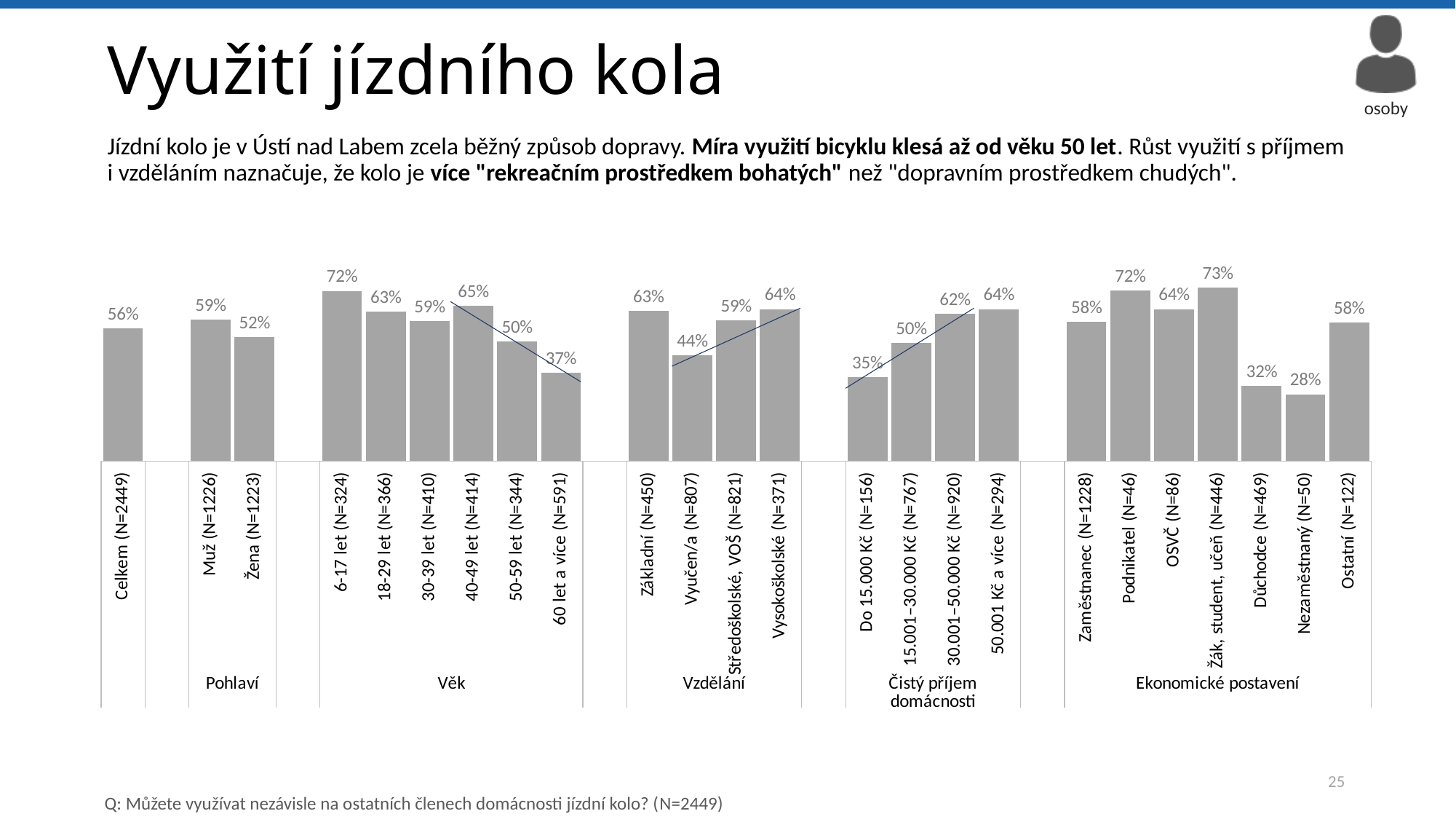
What is the value for Vyučen/a? 44% Which category in the Ekonomické postavení group has the highest value? Žák, student, učeň Which is larger, the value for Podnikatel or the value for OSVČ? Podnikatel Which category in the Čistý příjem domácnosti group has the lowest value? Do 15.000 Kč What is the value for Nezaměstnaný (N=50)? 28% What kind of chart is shown on the slide? Bar chart What is the difference between the values for Muž and Žena? 7% How many bars are plotted in the chart? 24 Do the values rise or fall across the Čistý příjem domácnosti categories from Do 15.000 Kč to 50.001 Kč a více? Rise What is the value for the 60 let a více age group? 37% What is the difference between the values for 6-17 let and 50-59 let? 22% What is the value for Celkem (N=2449)? 56%